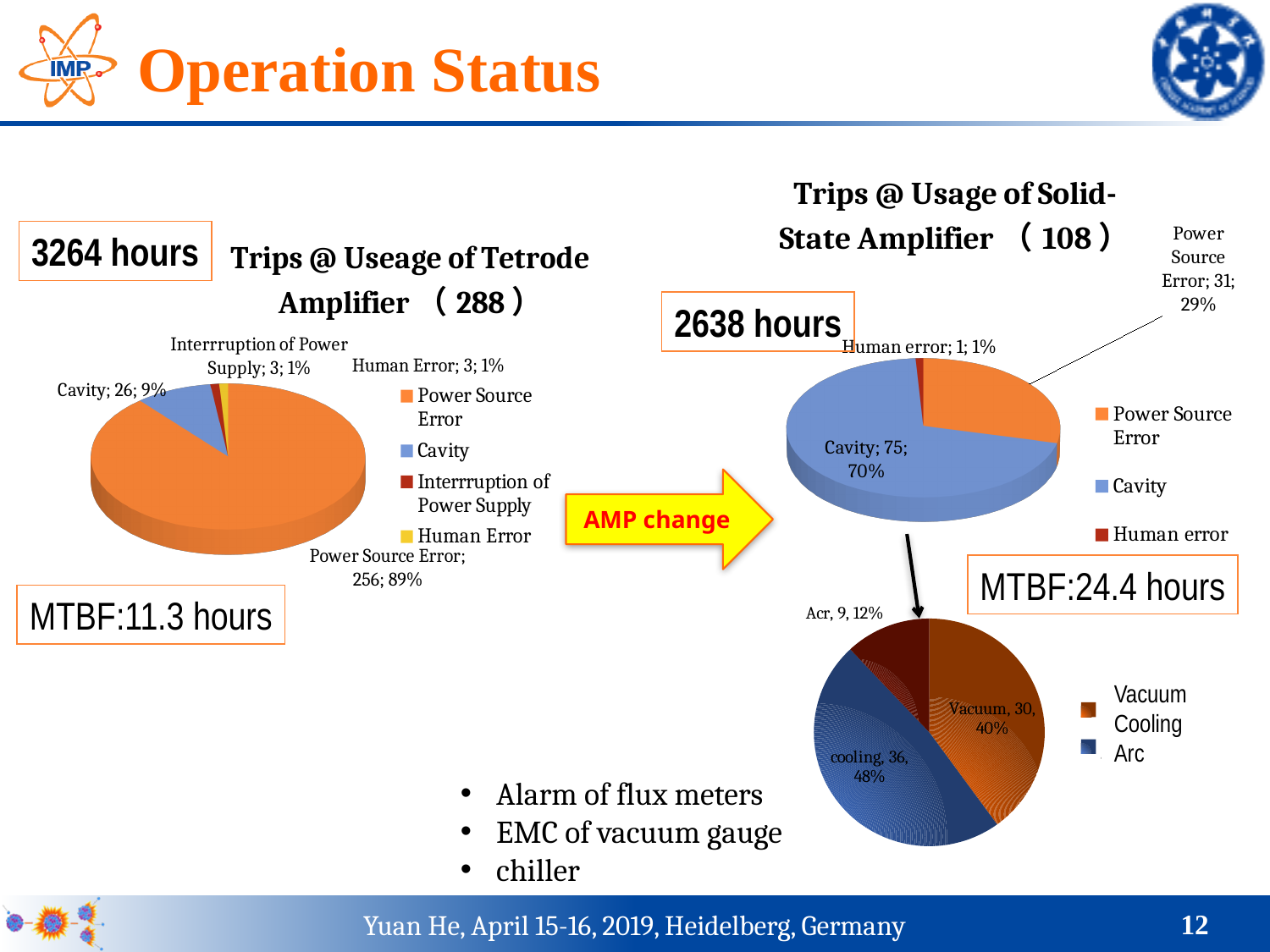
In the 'Trips @ Useage of Tetrode Amplifier (288)' chart, what is the difference between the Power Source Error count and the Cavity count? 230 In the 'Trips @ Useage of Tetrode Amplifier (288)' chart, how many trips are attributed to Power Source Error? 256 In the 'Trips @ Usage of Solid-State Amplifier (108)' chart, what share of trips is attributed to Power Source Error? 29% In the 'Trips @ Usage of Solid-State Amplifier (108)' chart, how many categories are shown? 3 In the bottom-right pie chart, what is the value for cooling? 36 In the bottom-right pie chart, which is larger, Vacuum or Arc? Vacuum In the 'Trips @ Usage of Solid-State Amplifier (108)' chart, which category has the smallest slice? Human error In the 'Trips @ Useage of Tetrode Amplifier (288)' chart, which category has the largest slice? Power Source Error In the 'Trips @ Usage of Solid-State Amplifier (108)' chart, how many trips are attributed to Cavity? 75 In the 'Trips @ Useage of Tetrode Amplifier (288)' chart, what share of trips is attributed to Cavity? 9% In the 'Trips @ Useage of Tetrode Amplifier (288)' chart, how many entries does the legend list? 4 What kind of chart is the 'Trips @ Usage of Solid-State Amplifier (108)' chart? Pie chart